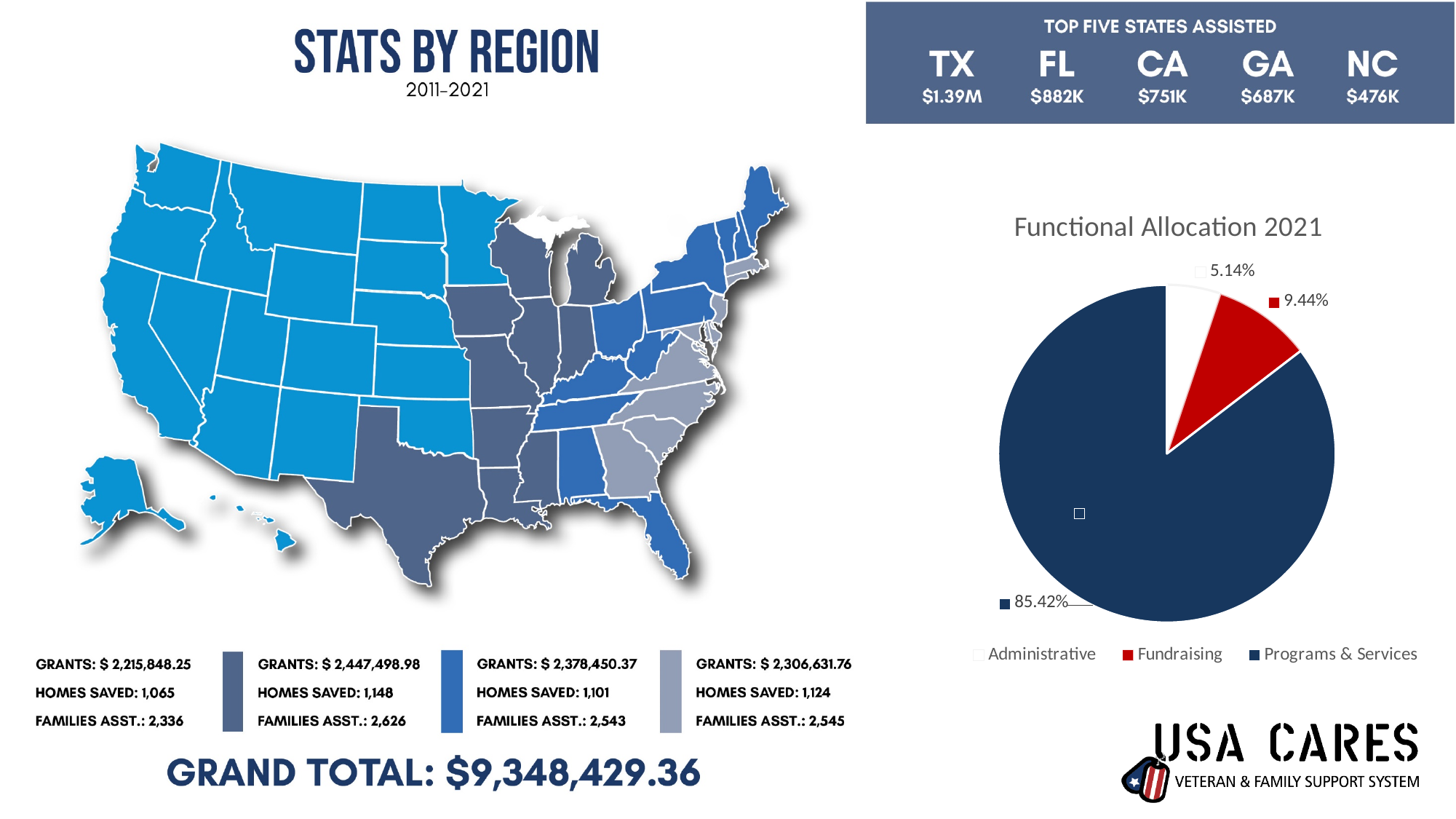
In the Functional Allocation 2021 chart, what is the difference in percentage points between Fundraising and Administrative? 4.30 In the Functional Allocation 2021 chart, which is larger: Fundraising or Administrative? Fundraising In the Functional Allocation 2021 chart, what percentage is allocated to Programs & Services? 85.42% How many categories does the Functional Allocation 2021 chart show? 3 In the Functional Allocation 2021 chart, what colour is the Fundraising slice? Red In the Functional Allocation 2021 chart, which category has the smallest share? Administrative In the Functional Allocation 2021 chart, which category has the largest share? Programs & Services In the Functional Allocation 2021 chart, what is the difference in percentage points between Programs & Services and Fundraising? 75.98 In the Functional Allocation 2021 chart, what percentage is allocated to Fundraising? 9.44% What is the title of the pie chart on the right side of the slide? Functional Allocation 2021 In the Functional Allocation 2021 chart, what percentage is allocated to Administrative? 5.14% What type of chart is the Functional Allocation 2021 chart? Pie chart